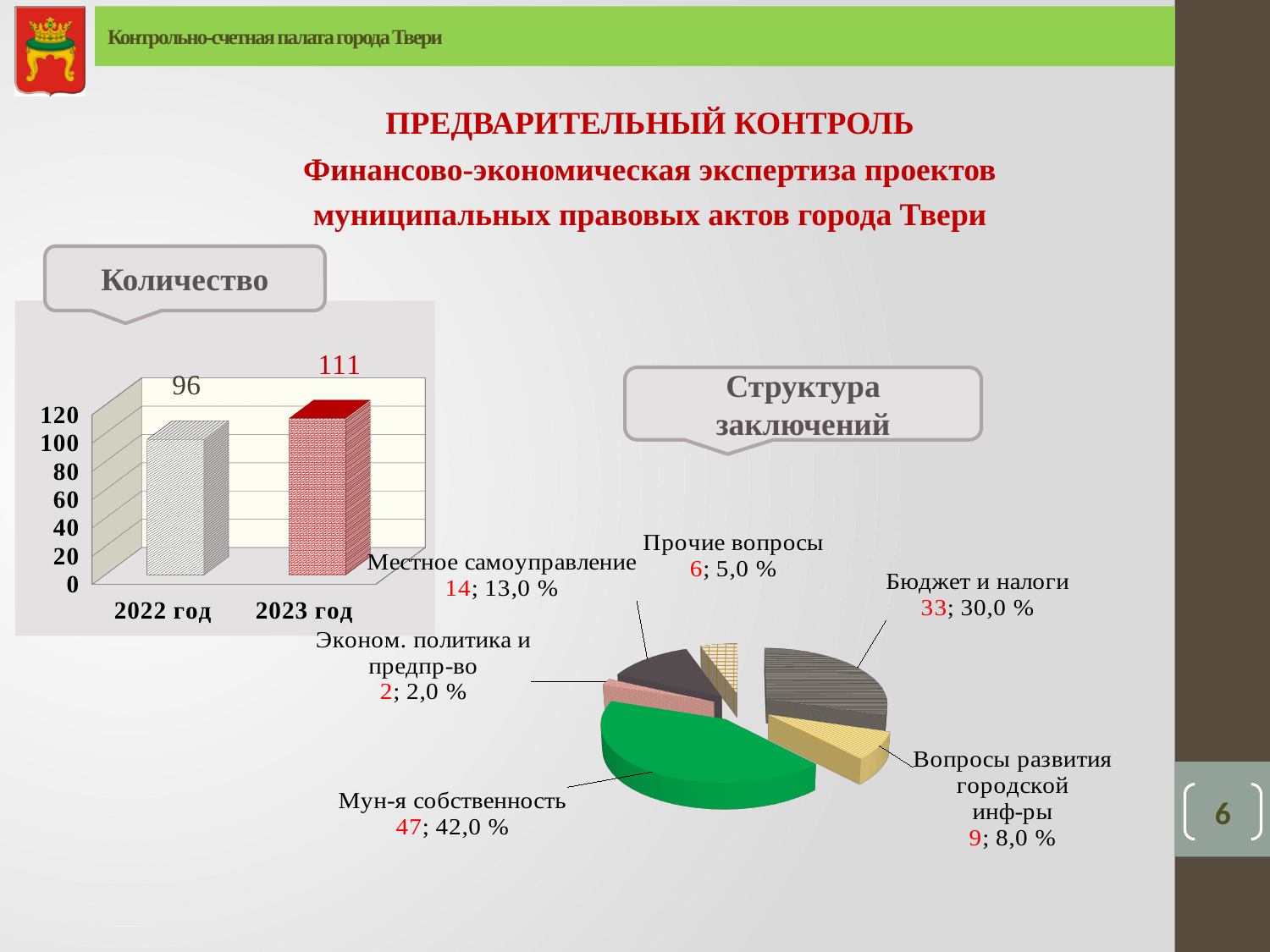
In the "Структура заключений" pie chart, what is the value for Бюджет и налоги? 33; 30,0 % In the "Количество" bar chart, what is the value for 2023 год? 111 In the "Структура заключений" pie chart, which category has the largest slice? Мун-я собственность In the "Количество" bar chart, what is the value for 2022 год? 96 In the "Структура заключений" pie chart, which category has the smallest slice? Эконом. политика и предпр-во In the "Структура заключений" pie chart, what share does Местное самоуправление have? 13,0 % What kind of chart is the "Количество" chart? bar chart In the "Структура заключений" pie chart, which is larger: Прочие вопросы or Вопросы развития городской инф-ры? Вопросы развития городской инф-ры In the "Количество" bar chart, what is the difference between the 2023 год and 2022 год values? 15 What kind of chart is the "Структура заключений" chart? pie chart In the "Количество" bar chart, do the values rise or fall from 2022 год to 2023 год? rise In the "Структура заключений" pie chart, how many categories are shown? 6